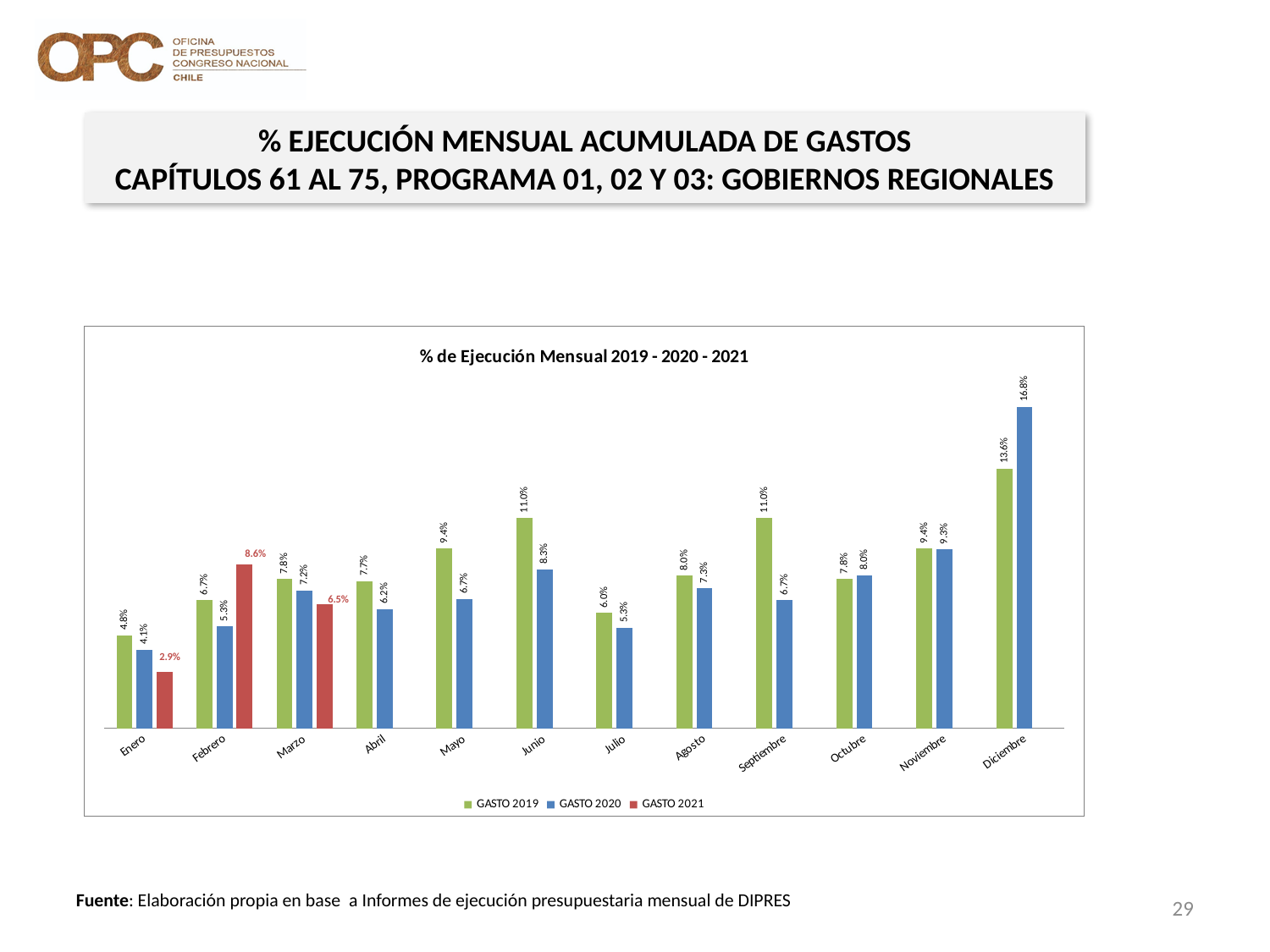
What kind of chart is shown? Bar chart What is the value for GASTO 2021 in Febrero? 8.6% Which is larger in Septiembre, GASTO 2019 or GASTO 2020? GASTO 2019 How many series does the legend list? 3 Which month has the lowest value for GASTO 2019? Enero What is the title of the chart? % de Ejecución Mensual 2019 - 2020 - 2021 Which month has the highest value for GASTO 2020? Diciembre What is the value for GASTO 2019 in Diciembre? 13.6% Which colour represents GASTO 2021 in the chart? Red How many months are shown on the x axis? 12 What is the value for GASTO 2020 in Junio? 8.3% What is the difference between GASTO 2020 and GASTO 2019 in Diciembre? 3.2%